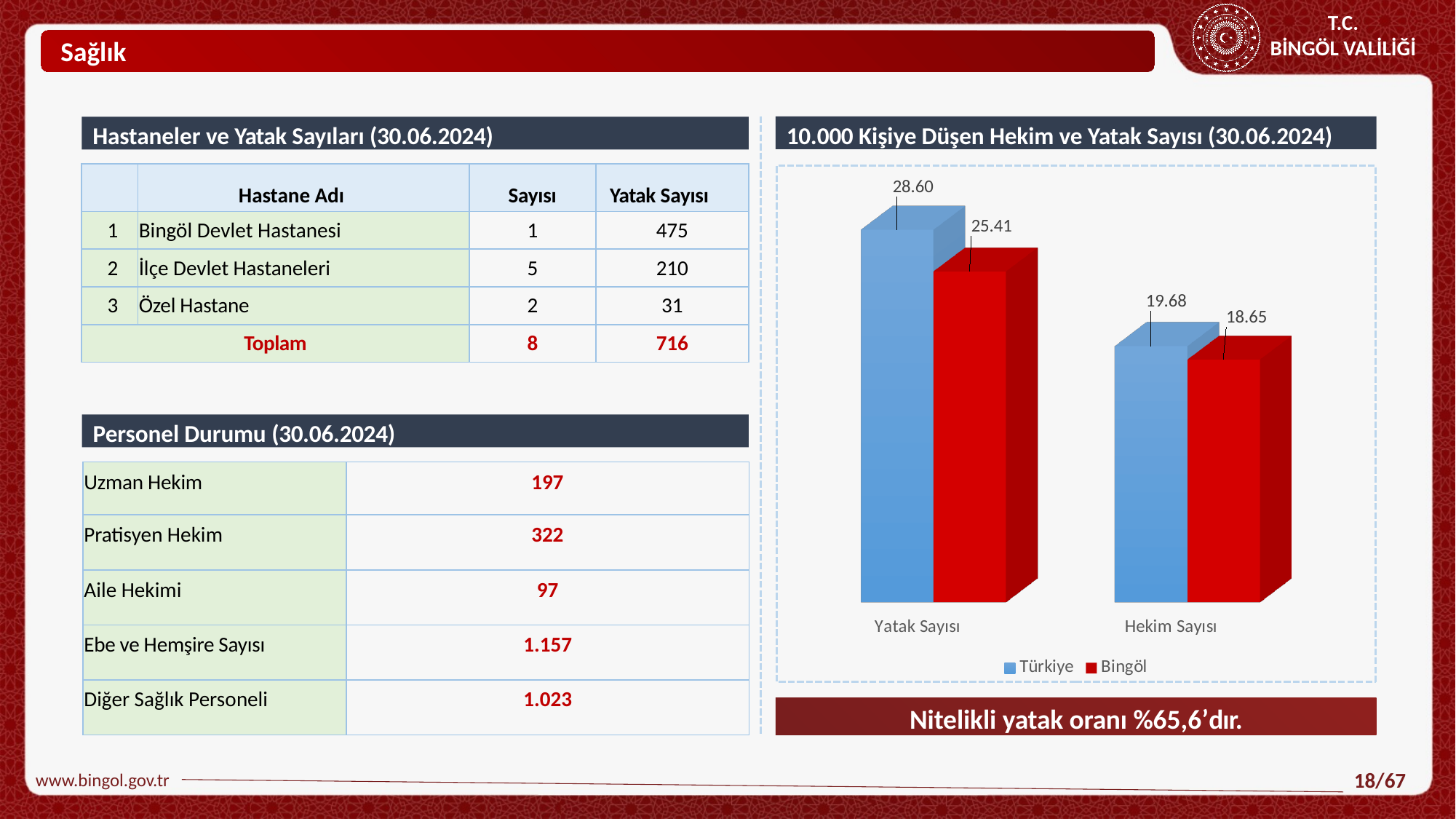
How many categories are shown on the x axis of the chart? 2 What is the Bingöl value for Yatak Sayısı in the chart? 25.41 Which series has the highest value in the chart, and for which category? Türkiye, Yatak Sayısı What is the Türkiye value for Yatak Sayısı in the chart? 28.60 Which bar in the chart has the lowest value? Bingöl, Hekim Sayısı How many series does the chart legend list? 2 What is the difference between the Türkiye and Bingöl values for Hekim Sayısı? 1.03 For Hekim Sayısı, which is larger: the Türkiye value or the Bingöl value? Türkiye What is the Bingöl value for Hekim Sayısı in the chart? 18.65 What is the Türkiye value for Hekim Sayısı in the chart? 19.68 What is the difference between the Türkiye and Bingöl values for Yatak Sayısı? 3.19 What type of chart is shown on the slide? Bar chart